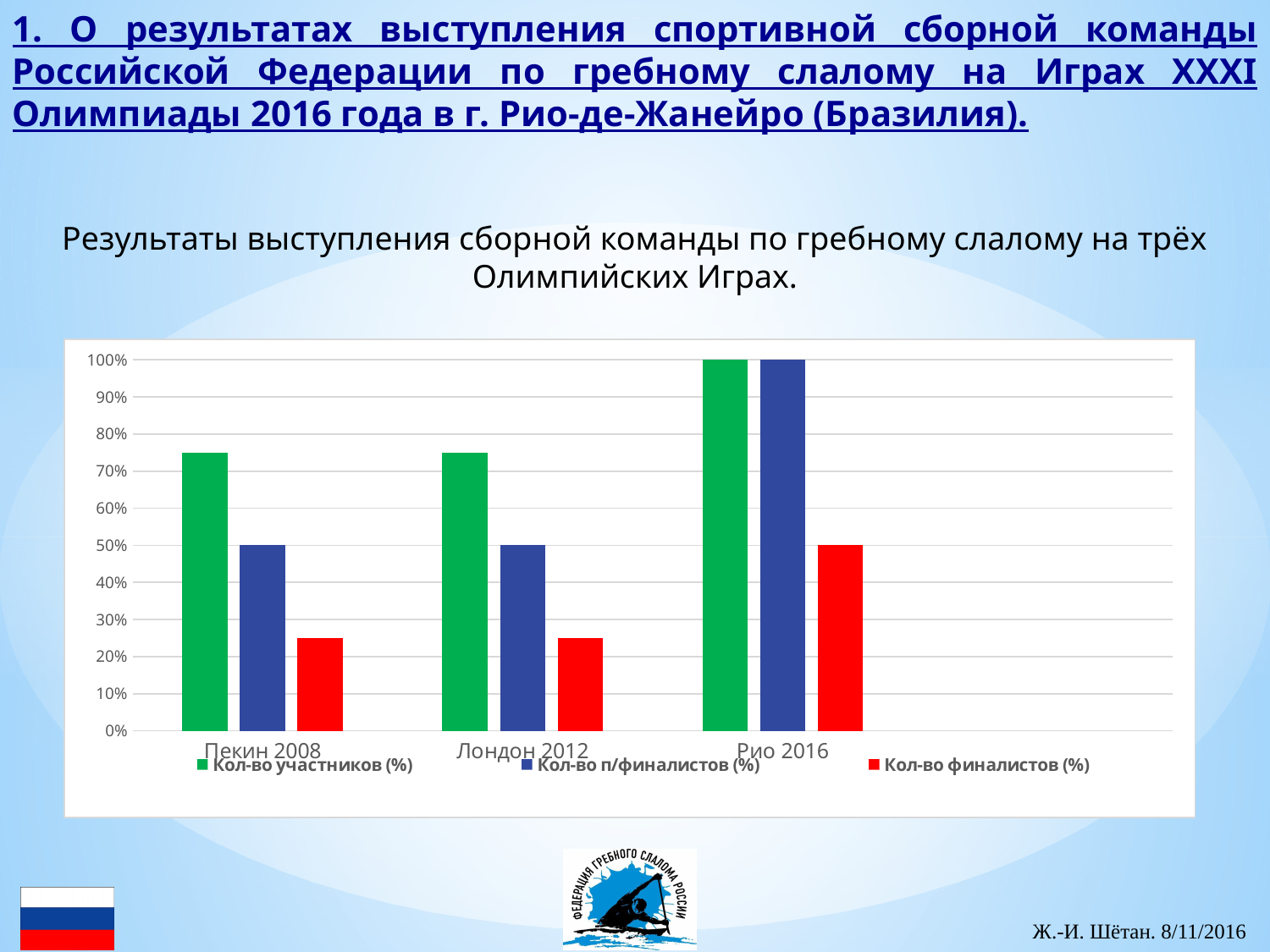
How many series does the chart legend list? 3 Is the value of Кол-во участников (%) for Лондон 2012 greater or less than 70%? greater Which is larger for Лондон 2012: Кол-во участников (%) or Кол-во финалистов (%)? Кол-во участников (%) How many Olympic Games (categories) are shown on the x axis of the chart? 3 What kind of chart is shown on the slide? bar chart Which Olympic Games has the highest value for Кол-во финалистов (%)? Рио 2016 Which colour represents Кол-во финалистов (%) in the chart legend? red What is the value of Кол-во финалистов (%) for Рио 2016? 50% What is the value of Кол-во п/финалистов (%) for Рио 2016? 100% What is the value of Кол-во участников (%) for Рио 2016? 100% What is the value of Кол-во п/финалистов (%) for Пекин 2008? 50% Is the value of Кол-во финалистов (%) for Пекин 2008 greater or less than 30%? less